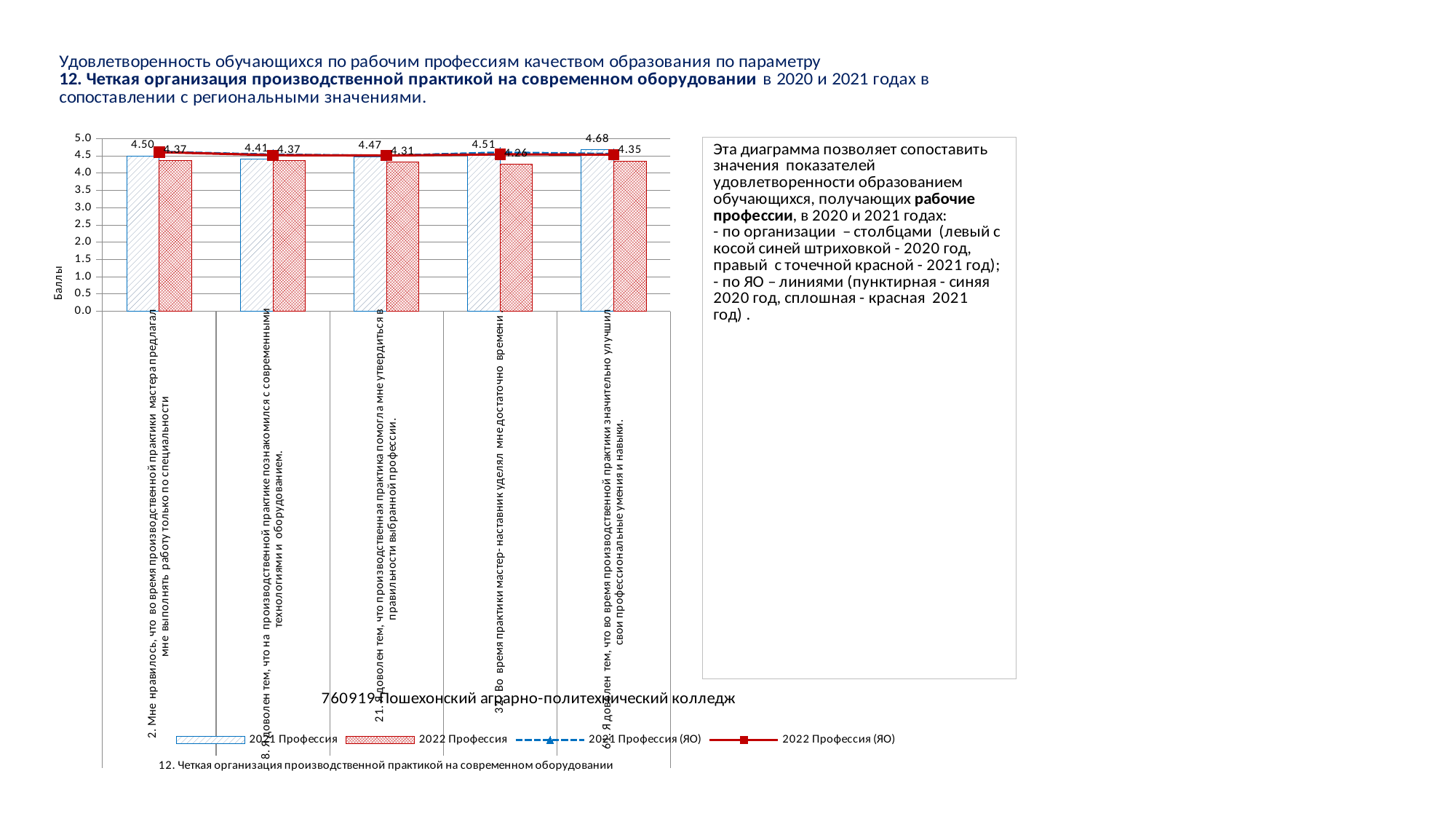
For category "21. Я доволен тем, что производственная практика помогла мне утвердиться в правильности выбранной профессии", which bar is larger: 2021 Профессия or 2022 Профессия? 2021 Профессия What is the value of the 2021 Профессия bar for category "8. Я доволен тем, что на производственной практике познакомился с современными технологиями и оборудованием"? 4.41 What is the value of the 2022 Профессия bar for category "8. Я доволен тем, что на производственной практике познакомился с современными технологиями и оборудованием"? 4.37 Which category has the lowest 2022 Профессия bar? Во время практики мастер-наставник уделял мне достаточно времени (4.26) What is the difference between the 2021 Профессия and 2022 Профессия bars for category "2. Мне нравилось, что во время производственной практики мастера предлагал мне выполнять работу только по специальности"? 0.13 How many series does the chart legend list? 4 How many categories are shown on the x axis of the chart? 5 What is the value of the 2021 Профессия bar for category "2. Мне нравилось, что во время производственной практики мастера предлагал мне выполнять работу только по специальности"? 4.50 What is the title of the vertical axis of the chart? Баллы What is the difference between the 2021 Профессия and 2022 Профессия bars for the category "Во время практики мастер-наставник уделял мне достаточно времени"? 0.25 What is the value of the 2022 Профессия bar for category "21. Я доволен тем, что производственная практика помогла мне утвердиться в правильности выбранной профессии"? 4.31 Which category has the highest 2021 Профессия bar? Я доволен тем, что во время производственной практики значительно улучшил свои профессиональные умения и навыки (4.68)